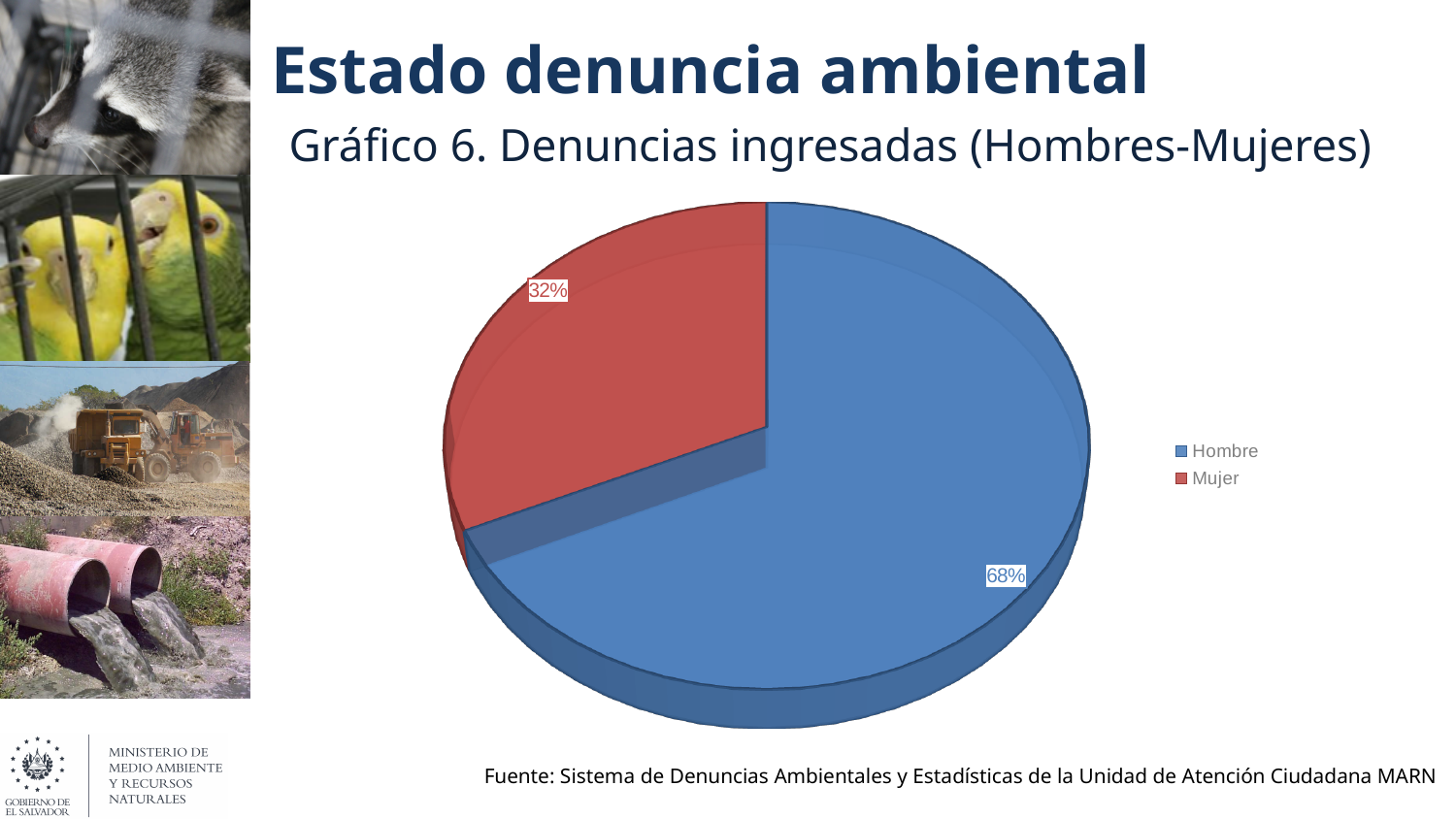
Which category has the largest share of the pie chart? Hombre What percentage of the pie chart corresponds to Mujer? 32% How many categories are shown in the pie chart? 2 What is the title of the chart (Gráfico 6)? Gráfico 6. Denuncias ingresadas (Hombres-Mujeres) Which category has the smallest share of the pie chart? Mujer Which slice is larger, Hombre or Mujer? Hombre What percentage of the pie chart corresponds to Hombre? 68% What is the difference in percentage points between the Hombre and Mujer slices? 36 What type of chart is shown on the slide? Pie chart What share of the pie does the Mujer slice represent? 32% How many entries does the legend list? 2 What colour is the Mujer slice in the pie chart? Red